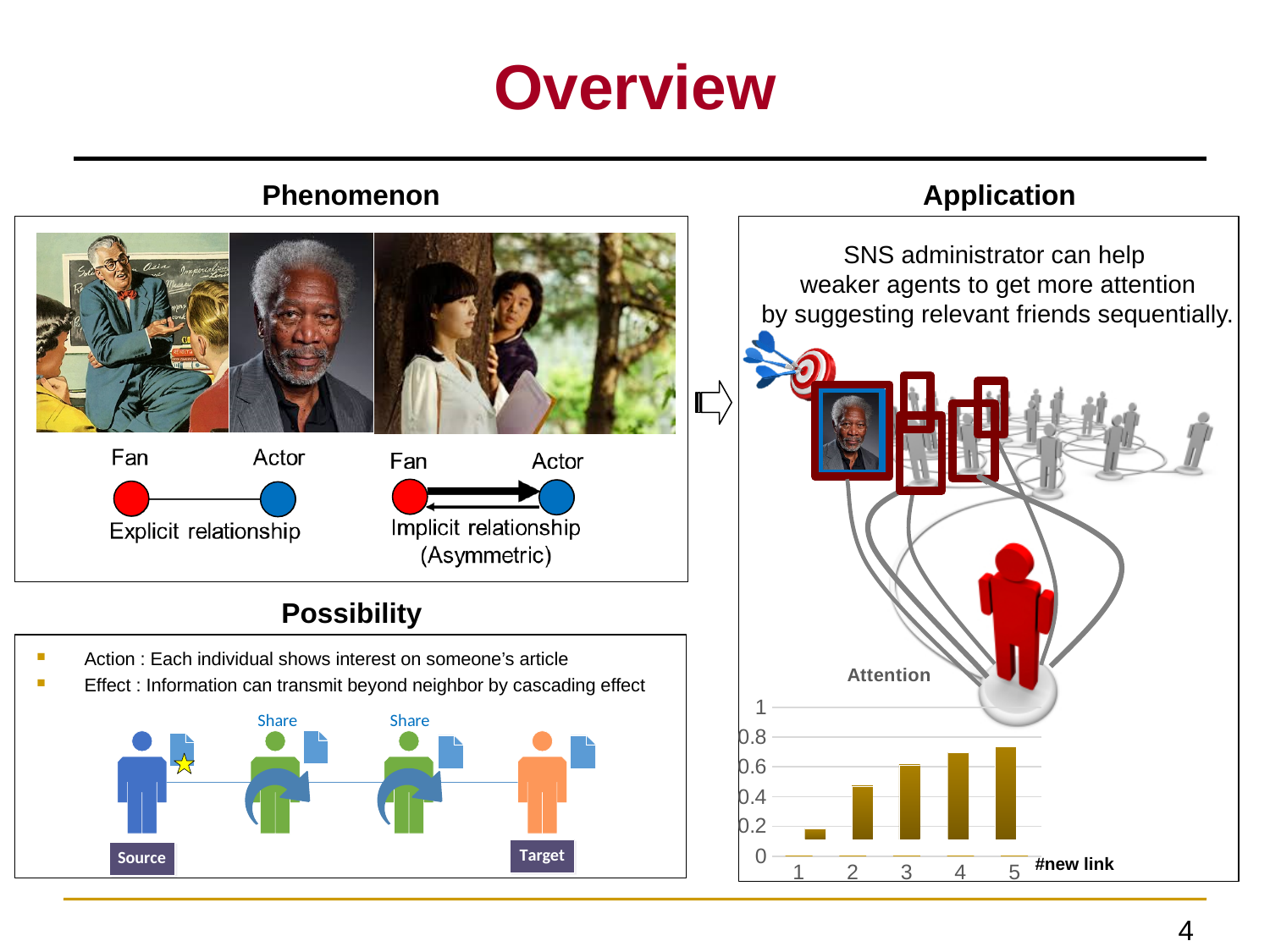
What kind of chart is shown at the bottom right of the slide under the 'Application' section? bar chart In the Attention bar chart, is the attention value for #new link 2 greater or less than 0.6? less In the Attention bar chart, is the attention value for #new link 4 greater or less than 0.6? greater What is the label of the horizontal axis of the Attention bar chart? #new link In the Attention bar chart, which has the higher attention value: #new link 2 or #new link 3? 3 In the Attention bar chart, which #new link value has the lowest attention? 1 In the Attention bar chart, is the attention value for #new link 5 greater or less than 0.8? less In the Attention bar chart, how many bars (values of #new link) are plotted? 5 In the Attention bar chart, do the attention values rise or fall as #new link increases from 1 to 5? rise In the Attention bar chart, which has the higher attention value: #new link 1 or #new link 2? 2